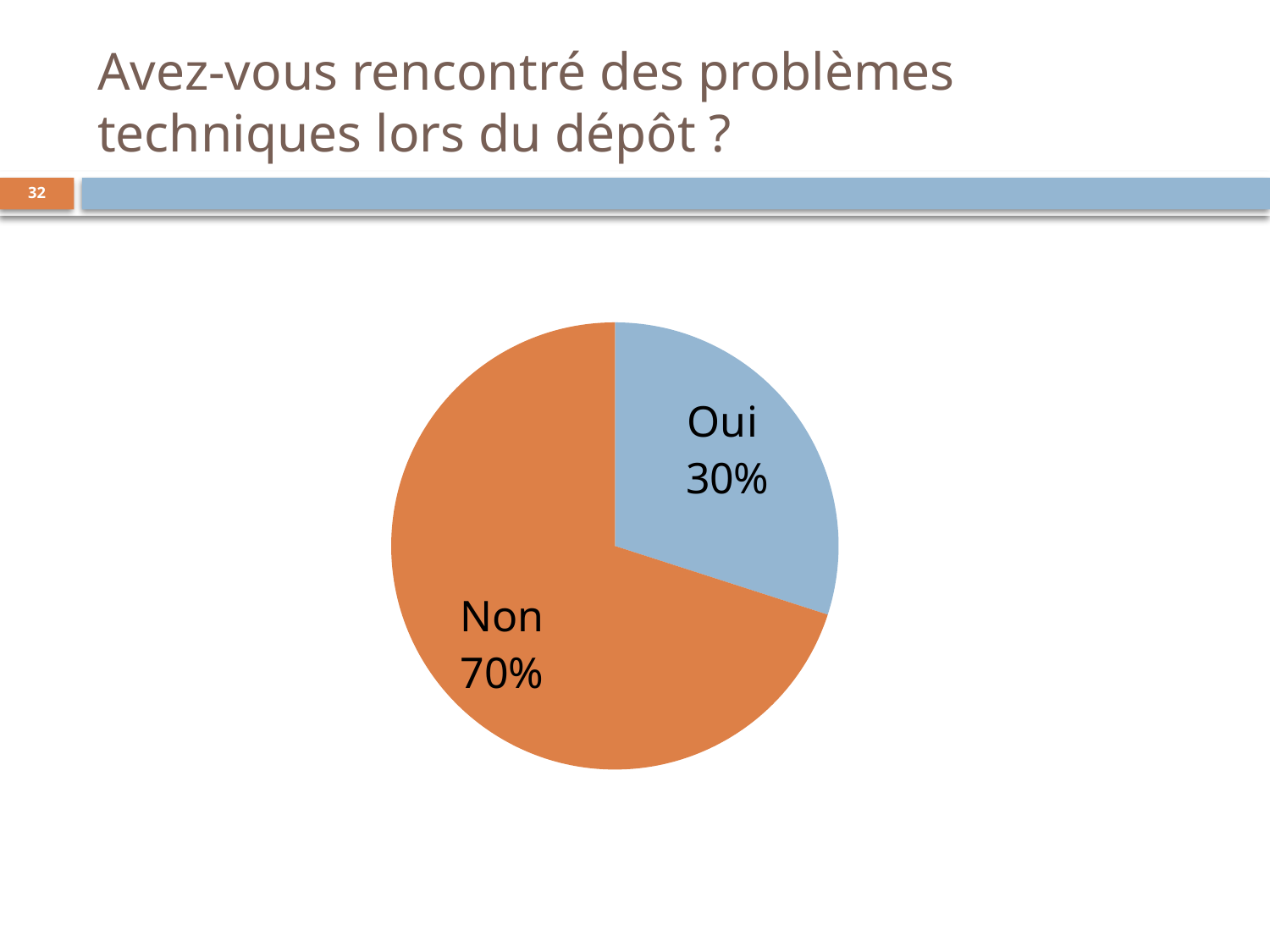
How many slices does the pie chart have? 2 Which slice of the pie is the smallest? Oui What is the difference in percentage points between the "Non" and "Oui" slices? 40 What colour is the "Oui" slice? blue What share of the pie does the "Non" slice represent? 70% What question does the slide title ask? Avez-vous rencontré des problèmes techniques lors du dépôt ? What percentage of respondents answered "Non"? 70% Which is larger, the "Oui" slice or the "Non" slice? Non What kind of chart is shown on the slide? pie chart Which slice of the pie is the largest? Non What percentage of respondents answered "Oui"? 30%